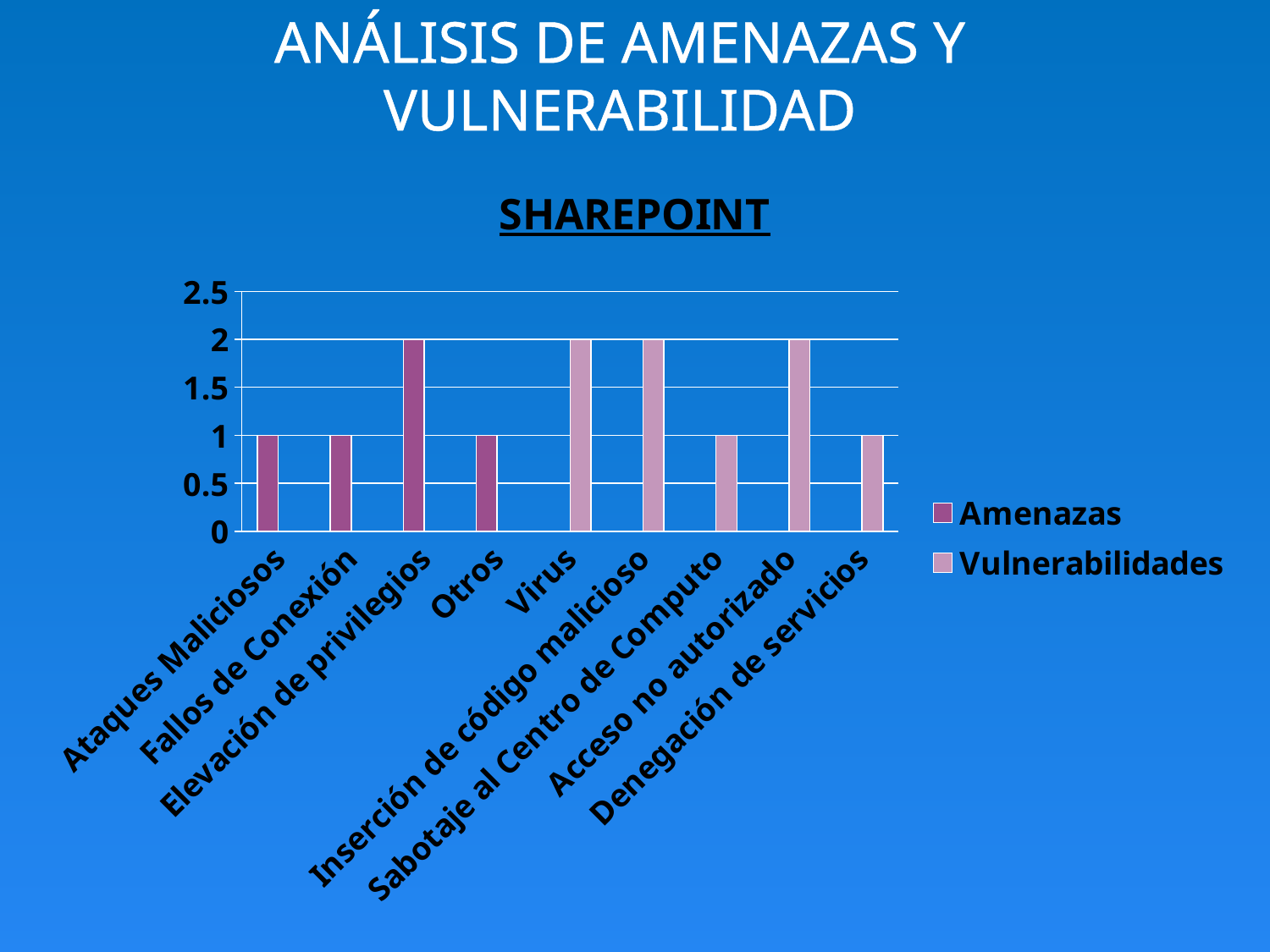
What is the value for Virus? 2 Which is larger, the value for Acceso no autorizado or the value for Otros? Acceso no autorizado What is the value for Elevación de privilegios? 2 Is the value for Elevación de privilegios greater or less than 1.5? greater What is the difference between the value for Inserción de código malicioso and the value for Fallos de Conexión? 1 What type of chart is shown on the slide? bar chart How many series does the legend list? 2 What is the value for Ataques Maliciosos? 1 What is the value for Sabotaje al Centro de Computo? 1 How many categories are shown on the x axis? 9 Which series does the bar for Virus belong to, according to the legend? Vulnerabilidades What is the value for Denegación de servicios? 1